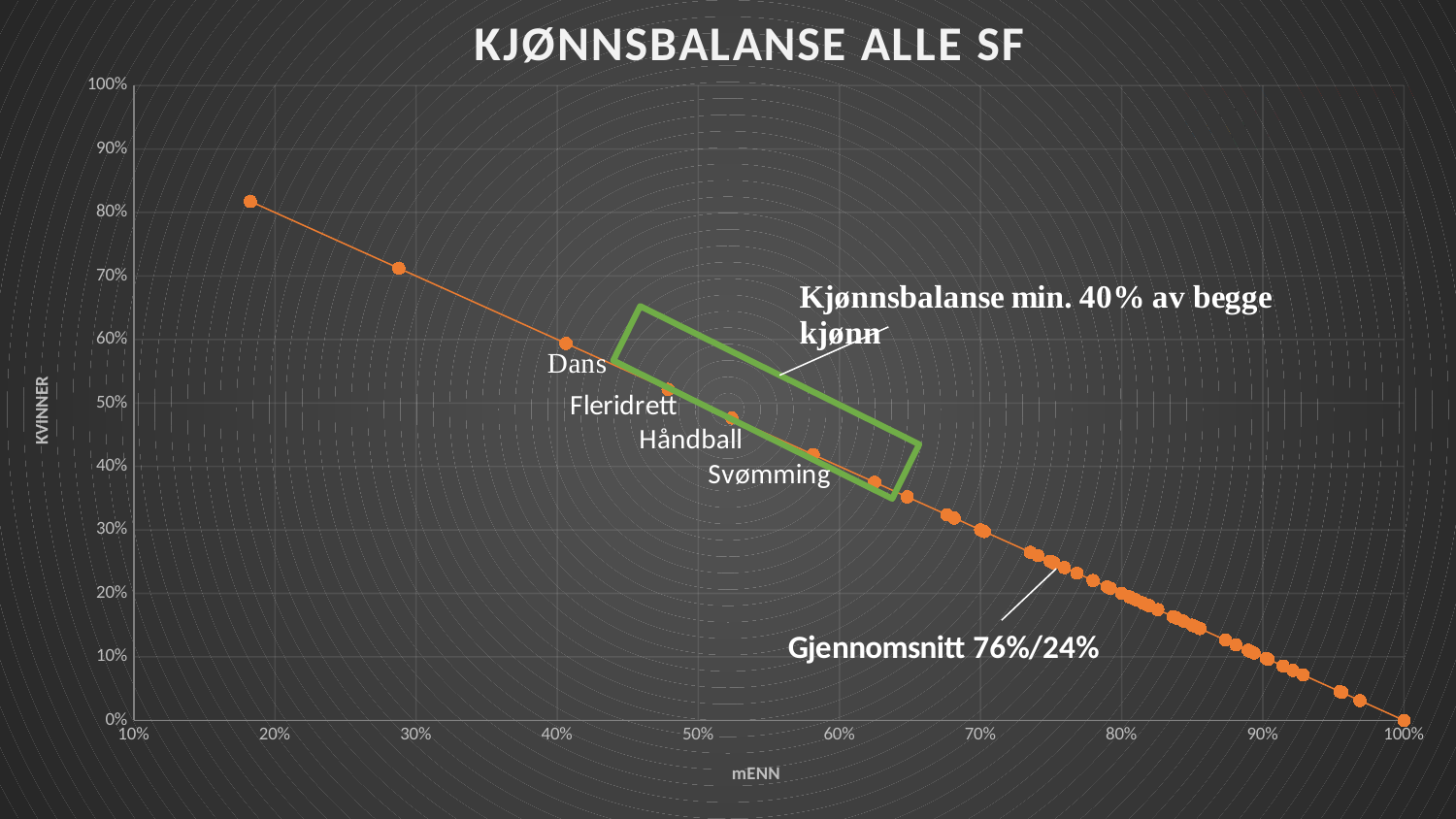
What is the label of the vertical axis? KVINNER Is the mENN value for Svømming greater or less than 50%? greater Is the KVINNER value for Håndball greater or less than 50%? less What kind of chart is shown on the slide? scatter chart Is the KVINNER value for Dans greater or less than 50%? greater What average (Gjennomsnitt) split is annotated on the chart? 76%/24% Among the labelled sports, which has the lowest KVINNER share? Svømming How many sports are labelled by name on the chart? 4 As the mENN value increases along the x axis, do the KVINNER values rise or fall? fall Which of the labelled sports, Dans or Svømming, has the higher KVINNER share? Dans What is the title of the chart? KJØNNSBALANSE ALLE SF